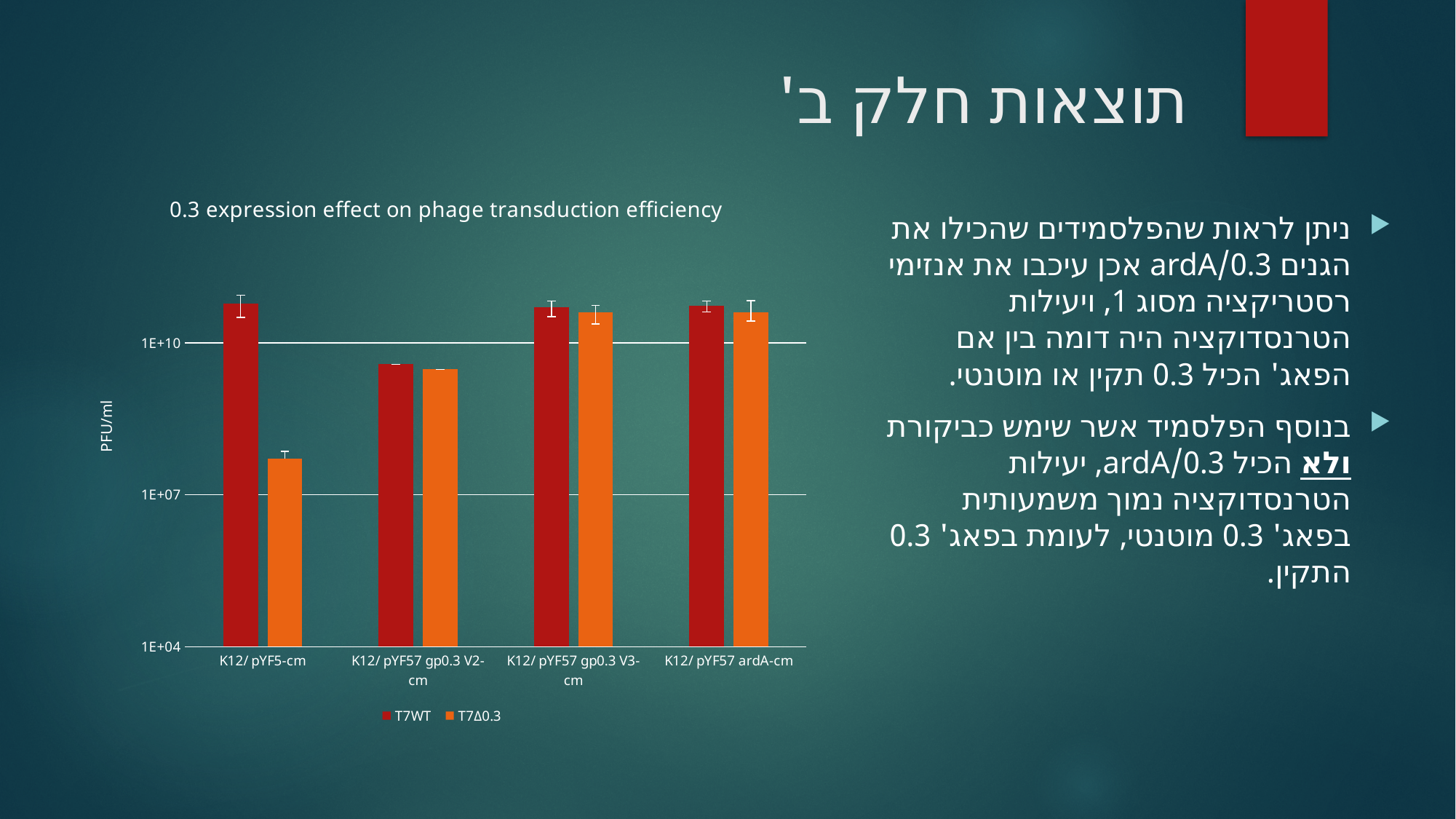
Which category has the lowest T7WT value? K12/ pYF57 gp0.3 V2-cm Which category has the lowest T7Δ0.3 value? K12/ pYF5-cm What kind of chart is shown on the slide? bar chart For K12/ pYF5-cm, which is larger: the T7WT value or the T7Δ0.3 value? T7WT How many series does the chart legend list? 2 What is the title of the chart? 0.3 expression effect on phage transduction efficiency Is the T7WT value for K12/ pYF5-cm greater or less than 1E+10? greater Is the T7Δ0.3 value for K12/ pYF5-cm greater or less than 1E+10? less What is the label of the y axis of the chart? PFU/ml How many categories are shown on the x axis of the chart? 4 Is the T7Δ0.3 value for K12/ pYF57 ardA-cm greater or less than 1E+07? greater